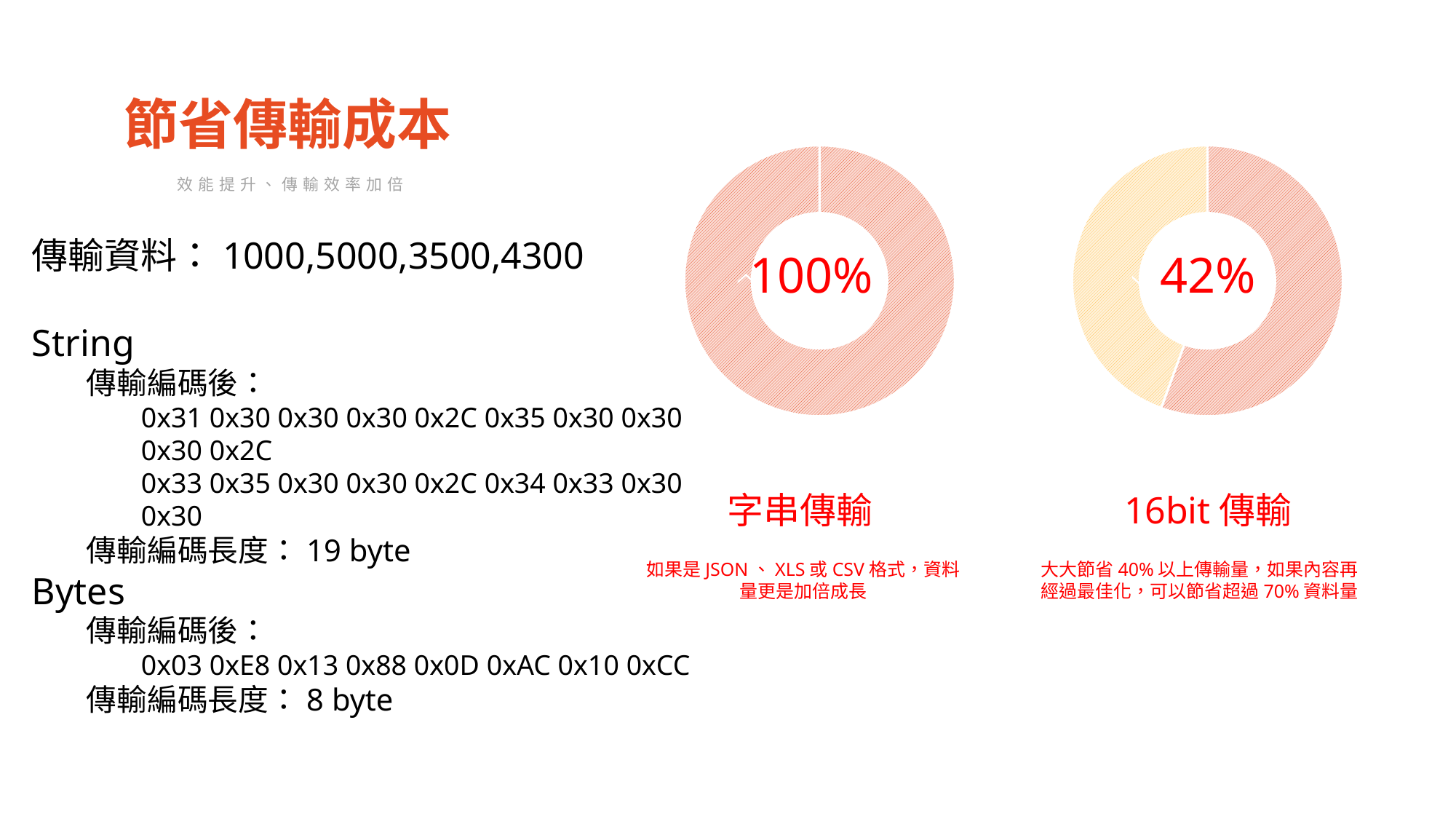
Which chart shows the higher percentage, 字串傳輸 or 16bit 傳輸? 字串傳輸 In the 16bit 傳輸 chart, what percentage is printed in the centre? 42% Which chart shows the lowest percentage value? 16bit 傳輸 Is the percentage shown for 16bit 傳輸 greater or less than 50%? less How many donut charts are shown on the slide? 2 How many differently coloured segments does the 16bit 傳輸 donut chart have? 2 In the 字串傳輸 chart, what percentage is printed in the centre? 100% What kind of chart is used for 字串傳輸 and 16bit 傳輸 on this slide? Donut (pie) chart What is the difference between the percentage shown for 字串傳輸 and the percentage shown for 16bit 傳輸? 58% What is the label under the left donut chart? 字串傳輸